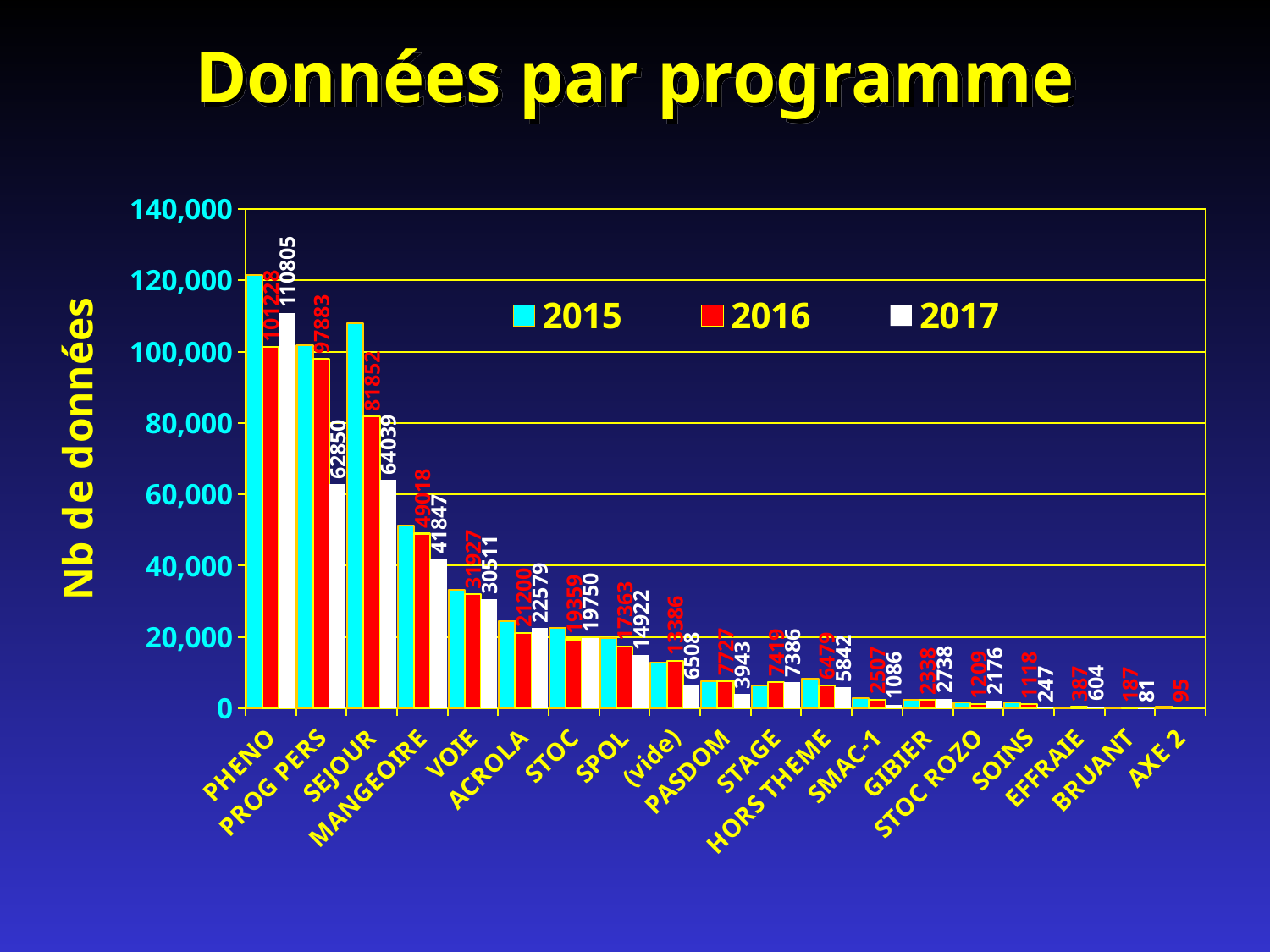
What is the 2017 value for VOIE? 30511 What is the difference between the 2016 and 2017 values for PROG PERS? 35033 For ACROLA, which year has the larger value, 2016 or 2017? 2017 What kind of chart is shown on the slide? bar chart Which programme has the highest 2017 value? PHENO How many programmes are shown on the x axis? 19 What is the 2016 value for SEJOUR? 81852 Is the 2015 value for SEJOUR greater or less than 100,000? greater What is the 2017 value for MANGEOIRE? 41847 What is the 2017 value for PHENO? 110805 What is the difference between the 2016 and 2017 values for SEJOUR? 17813 How many series does the legend list? 3